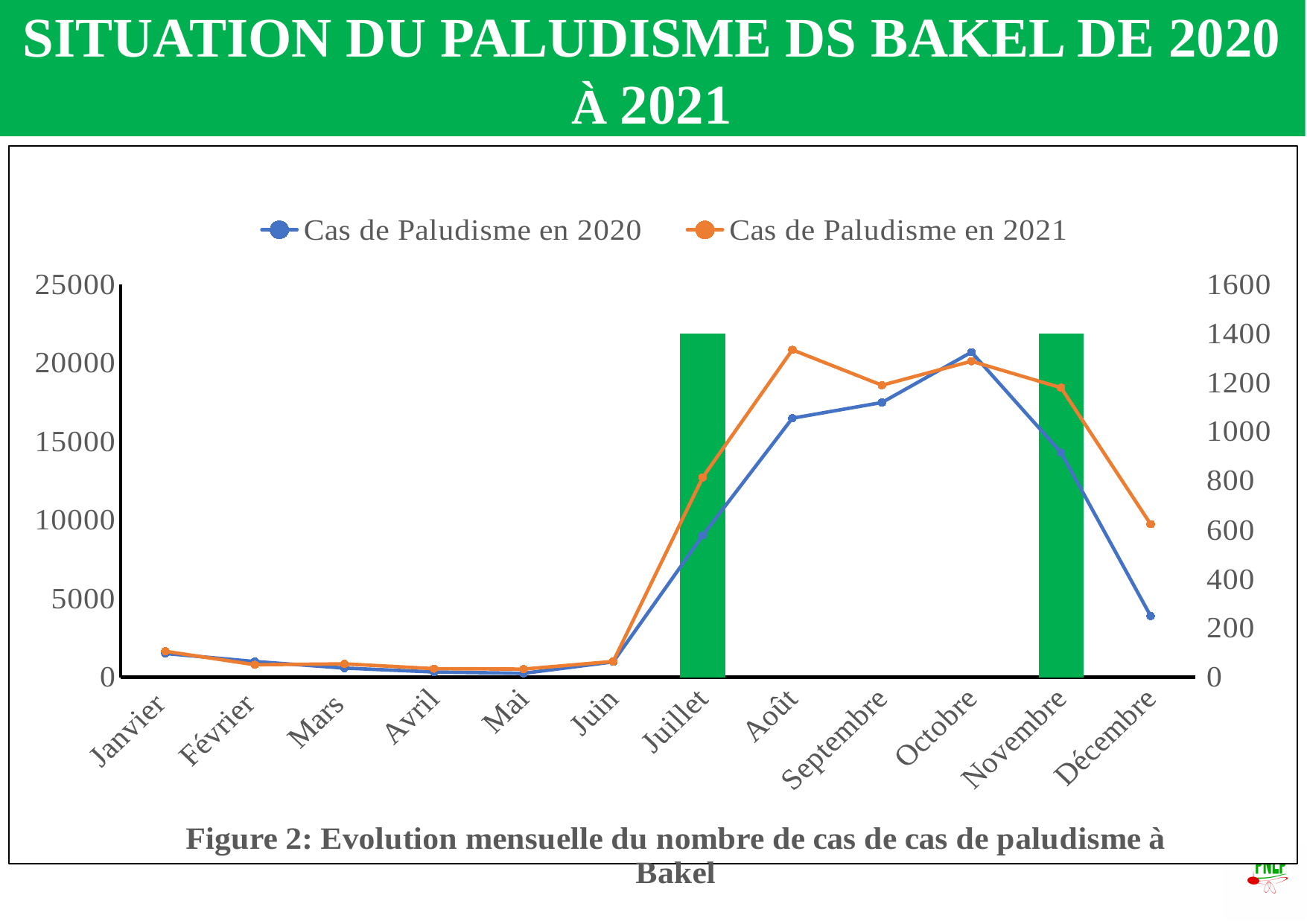
In which month does the 'Cas de Paludisme en 2021' series reach its highest point? Août For the 'Cas de Paludisme en 2020' series, which month has the higher value, Août or Septembre? Septembre How many series does the legend list? 2 How many months are plotted along the x axis? 12 Do the values of the 'Cas de Paludisme en 2020' series rise or fall from Octobre to Décembre? Fall For the 'Cas de Paludisme en 2020' series, which month has the higher value, Octobre or Décembre? Octobre What is the figure caption below the chart? Figure 2: Evolution mensuelle du nombre de cas de cas de paludisme à Bakel What kind of chart is shown on the slide? Combination bar and line chart For the 'Cas de Paludisme en 2021' series, which month has the higher value, Août or Septembre? Août In which month does the 'Cas de Paludisme en 2020' series reach its highest point? Octobre Which colour is used for the 'Cas de Paludisme en 2021' series? Orange Do the values of the 'Cas de Paludisme en 2021' series rise or fall from Juin to Août? Rise